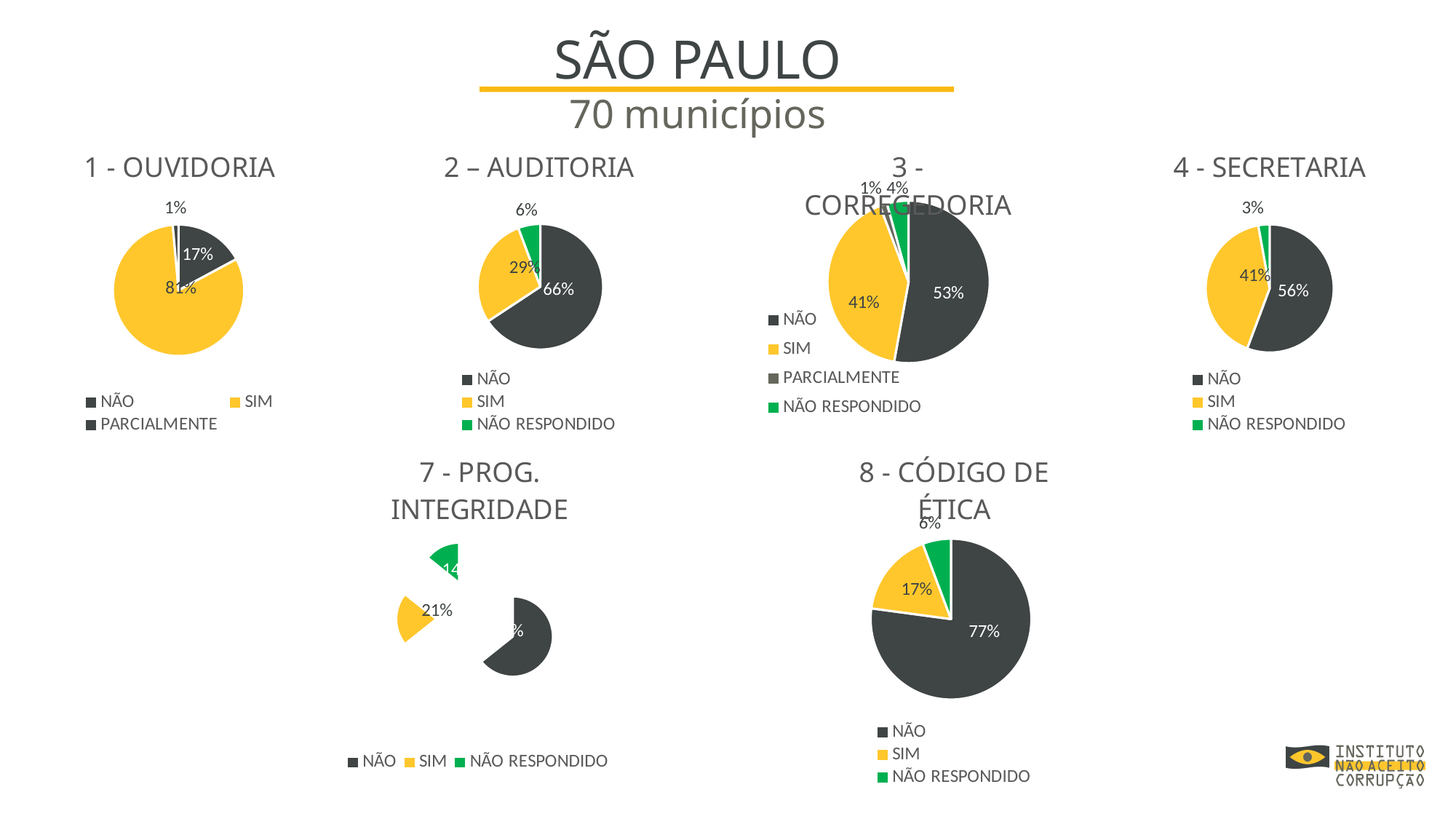
In the "4 - SECRETARIA" pie chart, what percentage is shown for NÃO RESPONDIDO? 3% How many categories does the legend of the "3 - CORREGEDORIA" pie chart list? 4 What type of chart is used for "7 - PROG. INTEGRIDADE"? Pie chart In the "4 - SECRETARIA" pie chart, which is larger, NÃO or SIM? NÃO In the "2 – AUDITORIA" pie chart, what percentage is shown for NÃO? 66% In the "8 - CÓDIGO DE ÉTICA" pie chart, what percentage is shown for SIM? 17% In the "8 - CÓDIGO DE ÉTICA" pie chart, which category has the largest share? NÃO In the "1 - OUVIDORIA" pie chart, which category has the smallest share? PARCIALMENTE How many pie charts are shown on the slide? 6 In the "3 - CORREGEDORIA" pie chart, what percentage is shown for SIM? 41% In the "1 - OUVIDORIA" pie chart, what percentage is shown for SIM? 81% In the "2 – AUDITORIA" pie chart, what is the difference in percentage points between NÃO and SIM? 37